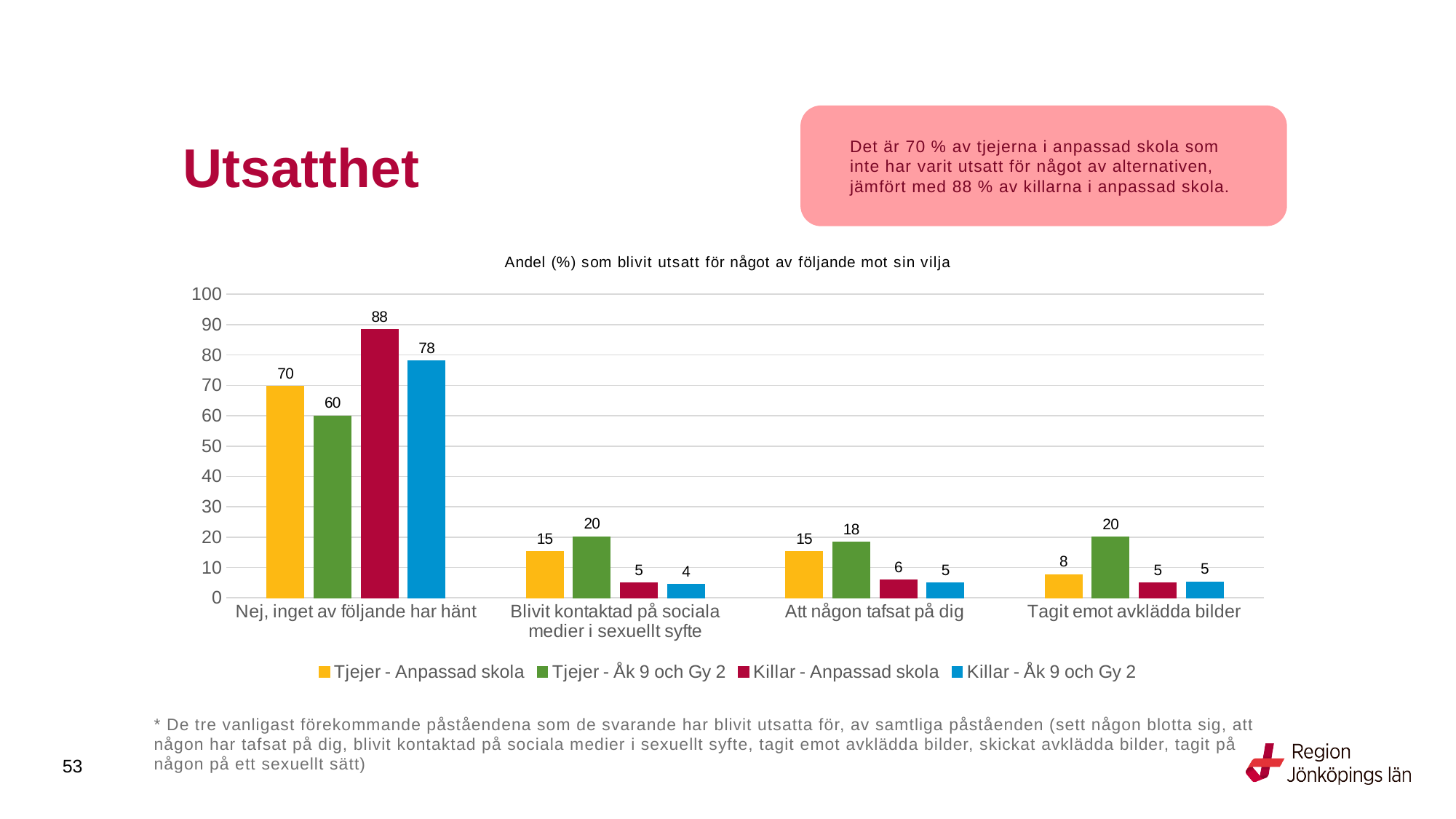
How many categories are shown on the x axis of the chart? 4 What is the value for Killar - Åk 9 och Gy 2 in the category 'Att någon tafsat på dig'? 5 What is the title of the chart? Andel (%) som blivit utsatt för något av följande mot sin vilja What kind of chart is shown on the slide? Bar chart In the category 'Tagit emot avklädda bilder', which is larger: Tjejer - Anpassad skola or Tjejer - Åk 9 och Gy 2? Tjejer - Åk 9 och Gy 2 What is the value for Tjejer - Åk 9 och Gy 2 in the category 'Blivit kontaktad på sociala medier i sexuellt syfte'? 20 Which series has the highest value in the category 'Nej, inget av följande har hänt'? Killar - Anpassad skola Which series has the lowest value in the category 'Blivit kontaktad på sociala medier i sexuellt syfte'? Killar - Åk 9 och Gy 2 How many series does the legend list? 4 What is the value for Killar - Anpassad skola in the category 'Nej, inget av följande har hänt'? 88 What is the difference between Killar - Anpassad skola and Tjejer - Anpassad skola in the category 'Nej, inget av följande har hänt'? 18 What is the value for Tjejer - Anpassad skola in the category 'Nej, inget av följande har hänt'? 70